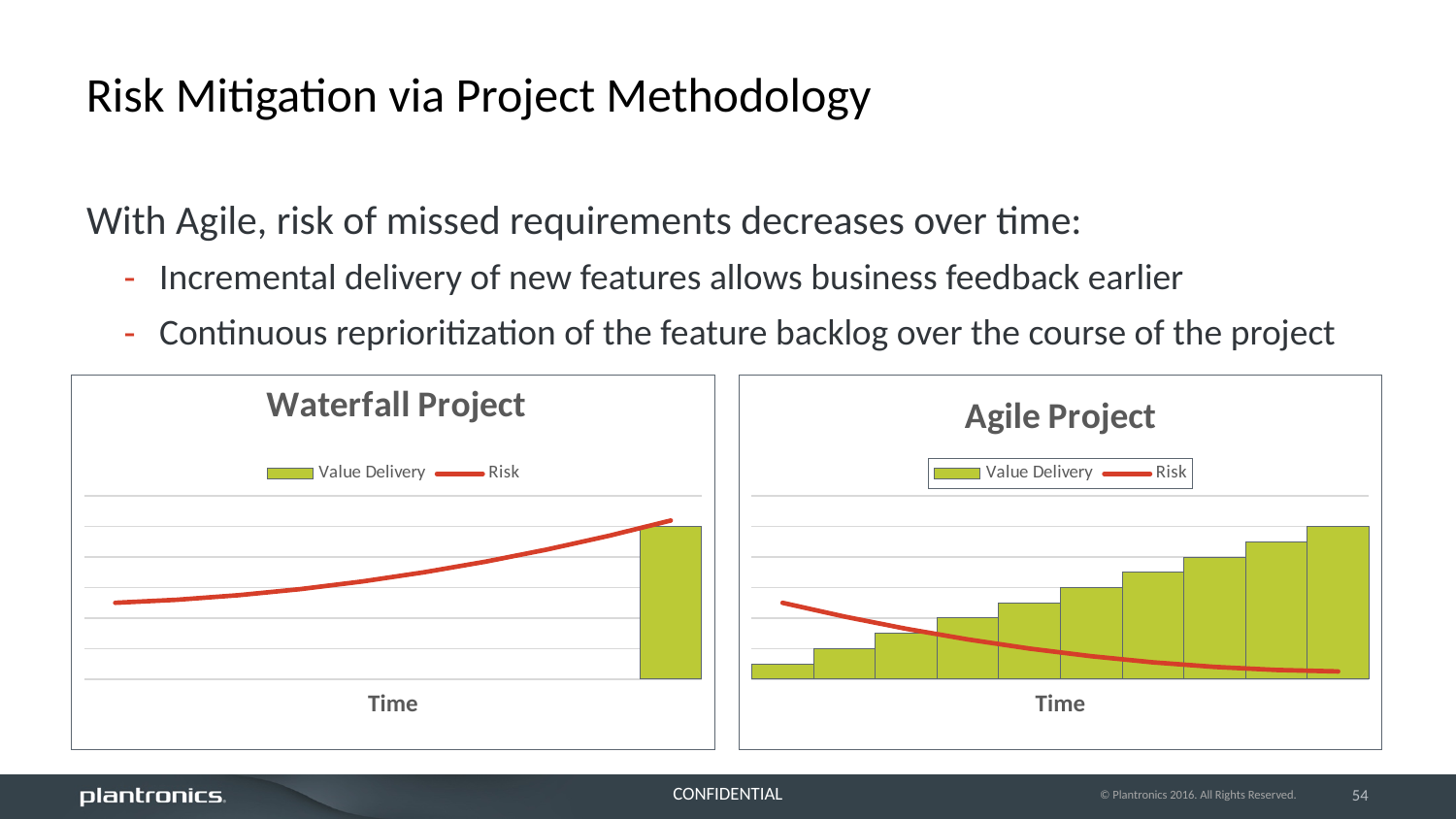
In the Waterfall Project chart, does the Risk line rise or fall along the Time axis? rise In the Agile Project chart, which series is drawn as a line rather than bars? Risk In the Agile Project chart, is the last Value Delivery bar taller or shorter than the first? taller How many Value Delivery bars are plotted in the Waterfall Project chart? 1 What kind of chart is the Agile Project chart, combining bars and a line? combination of a bar chart and a line chart What is the x-axis title of the Waterfall Project chart? Time How many series does the legend of the Agile Project chart list? 2 In the Agile Project chart, does the Risk line rise or fall along the Time axis? fall How many Value Delivery bars are plotted in the Agile Project chart? 10 How many series does the legend of the Waterfall Project chart list? 2 In the Agile Project chart, do the Value Delivery bars rise or fall along the Time axis? rise